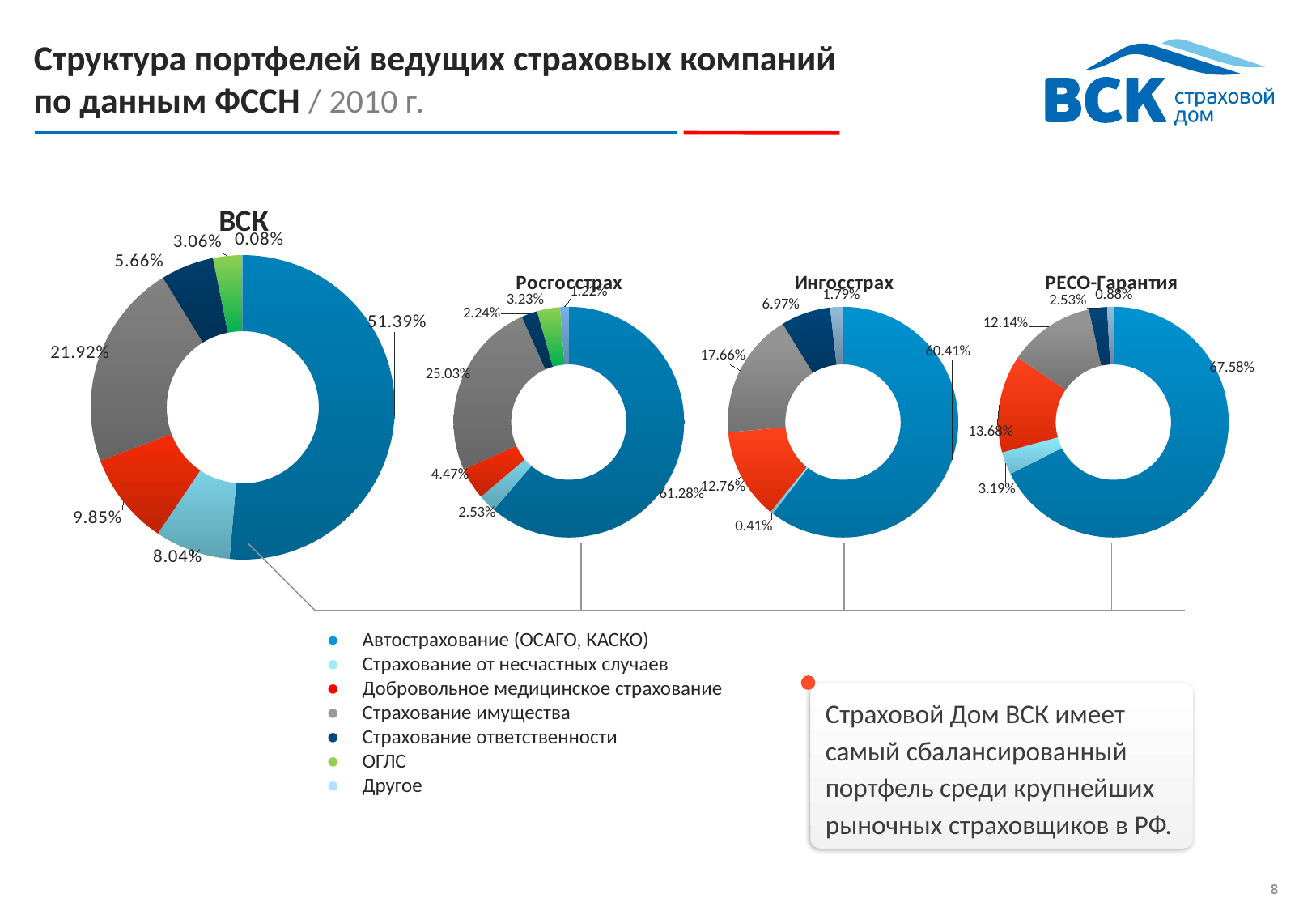
How many entries does the legend list? 7 In the РЕСО-Гарантия chart, what share does Автострахование (ОСАГО, КАСКО) hold? 67.58% In the Росгосстрах chart, what share does Страхование имущества hold? 25.03% In the Ингосстрах chart, what share does Добровольное медицинское страхование hold? 12.76% In the ВСК chart, what share does Автострахование (ОСАГО, КАСКО) hold? 51.39% How many company charts are shown on the slide? 4 What kind of chart is used for each company on this slide? Donut (pie) chart Which chart has the larger Страхование имущества share: ВСК (21.92%) or Ингосстрах (17.66%)? ВСК What is the difference between the Автострахование share in the РЕСО-Гарантия chart (67.58%) and in the ВСК chart (51.39%)? 16.19% In the Росгосстрах chart, what is the largest slice's value? 61.28% In the ВСК chart, what share does Страхование имущества hold? 21.92% In the ВСК chart, what is the smallest slice's value? 0.08%